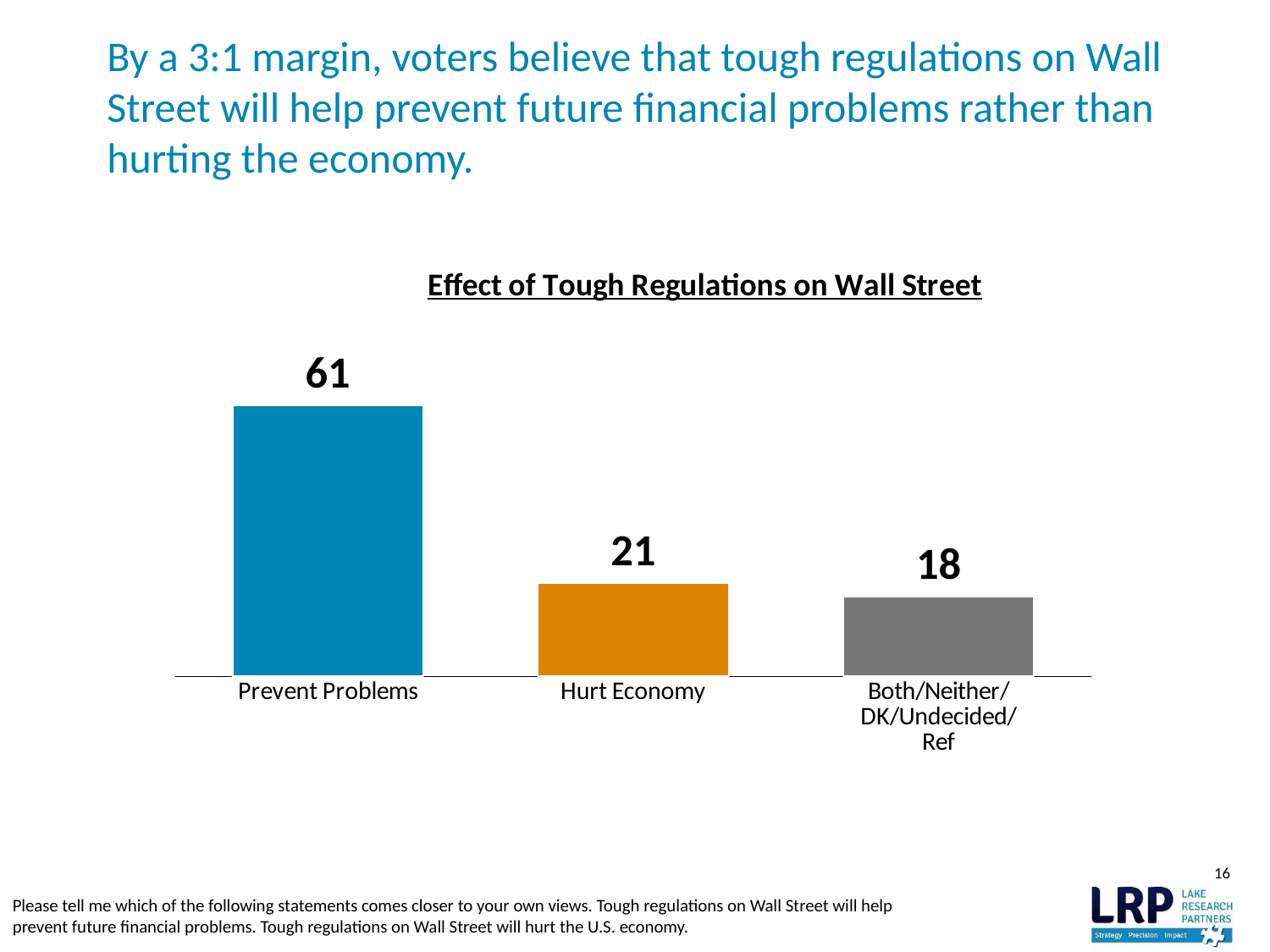
What colour is the bar for Hurt Economy? Orange Which category has the highest value? Prevent Problems What kind of chart is shown on the slide? Bar chart Which is larger, the value for Prevent Problems or the value for Hurt Economy? Prevent Problems What is the value for Both/Neither/DK/Undecided/Ref? 18 What is the value for Hurt Economy? 21 What is the difference between the values for Hurt Economy and Both/Neither/DK/Undecided/Ref? 3 What is the value for Prevent Problems? 61 What is the difference between the values for Prevent Problems and Hurt Economy? 40 How many categories are shown in the chart? 3 What is the title of the chart? Effect of Tough Regulations on Wall Street Which category has the lowest value? Both/Neither/DK/Undecided/Ref